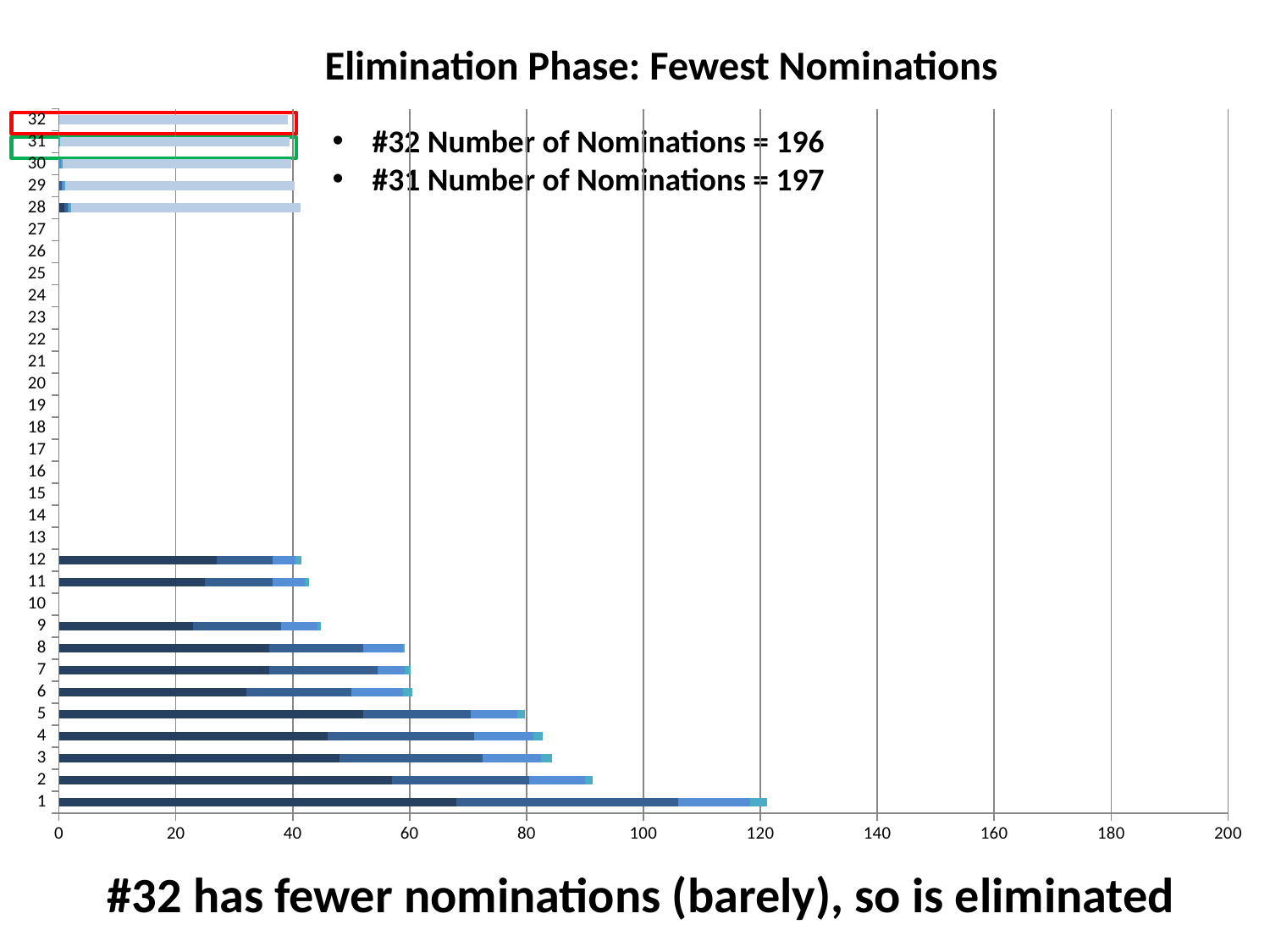
Which has the longer bar, category 2 or category 3? 2 Which category has the longest bar in the chart? 1 Which has the longer bar, category 8 or category 9? 8 What kind of chart is shown on the slide? bar chart What is the highest value shown on the horizontal axis of the chart? 200 Is the total bar length for category 9 greater or less than 40? greater What is the title of the chart on the slide? Elimination Phase: Fewest Nominations Going from category 1 up to category 9, do the bars generally get longer or shorter? shorter Is the total bar length for category 1 greater or less than 100? greater How many categories are listed on the vertical axis of the chart? 32 Is the total bar length for category 2 greater or less than 100? less Which category on the chart is outlined with a red box? 32